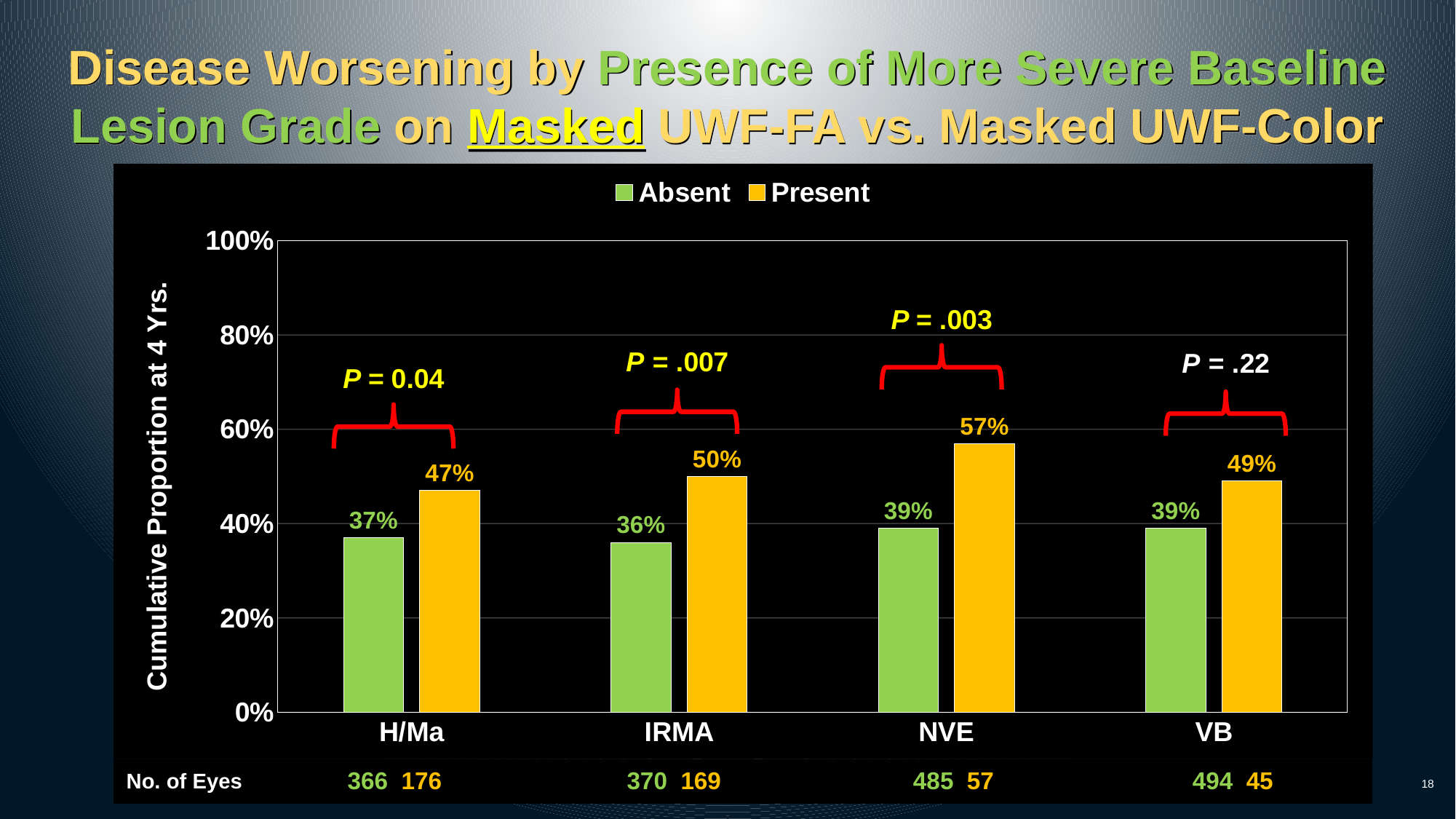
What is the difference between the Present and Absent values in the NVE category? 18% How many categories are shown on the x axis? 4 How many series does the legend list? 2 What is the difference between the Present and Absent values in the H/Ma category? 10% Which is larger in the VB category, the Absent value or the Present value? Present What is the value for the Present series in the H/Ma category? 47% What is the value for the Present series in the NVE category? 57% Which category has the lowest value for the Absent series? IRMA What kind of chart is shown on the slide? Bar chart What is the label of the y axis? Cumulative Proportion at 4 Yrs. Which category has the highest value for the Present series? NVE What is the value for the Absent series in the IRMA category? 36%